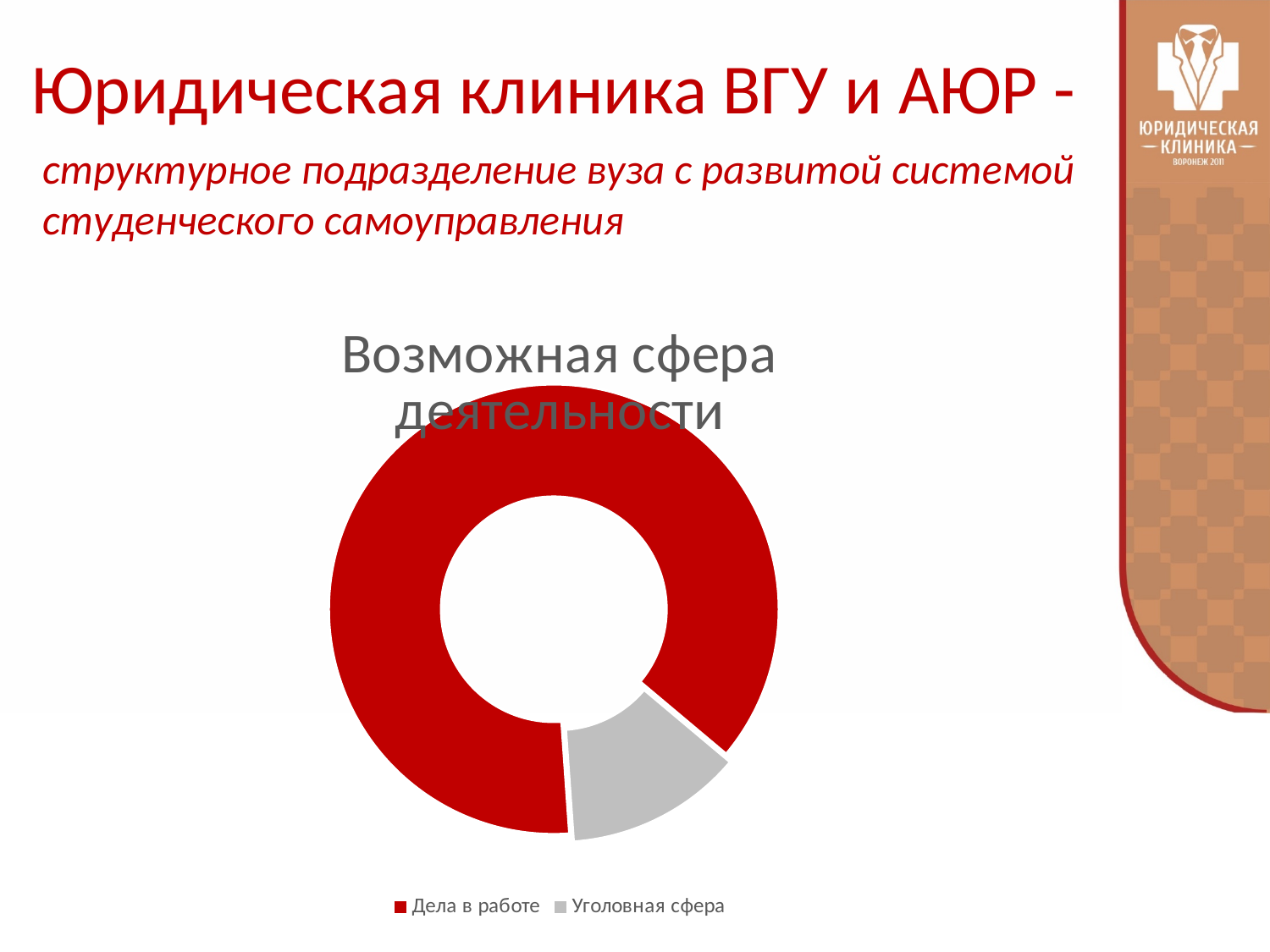
Which category takes up the largest part of the chart? Дела в работе Which category takes up the smallest part of the chart? Уголовная сфера How many categories does the chart's legend list? 2 Which is larger: the share for Дела в работе or the share for Уголовная сфера? Дела в работе What is the title of the chart? Возможная сфера деятельности What kind of chart is shown on the slide? doughnut chart Does Дела в работе account for more or less than half of the chart? more What colour represents Уголовная сфера in the chart? grey